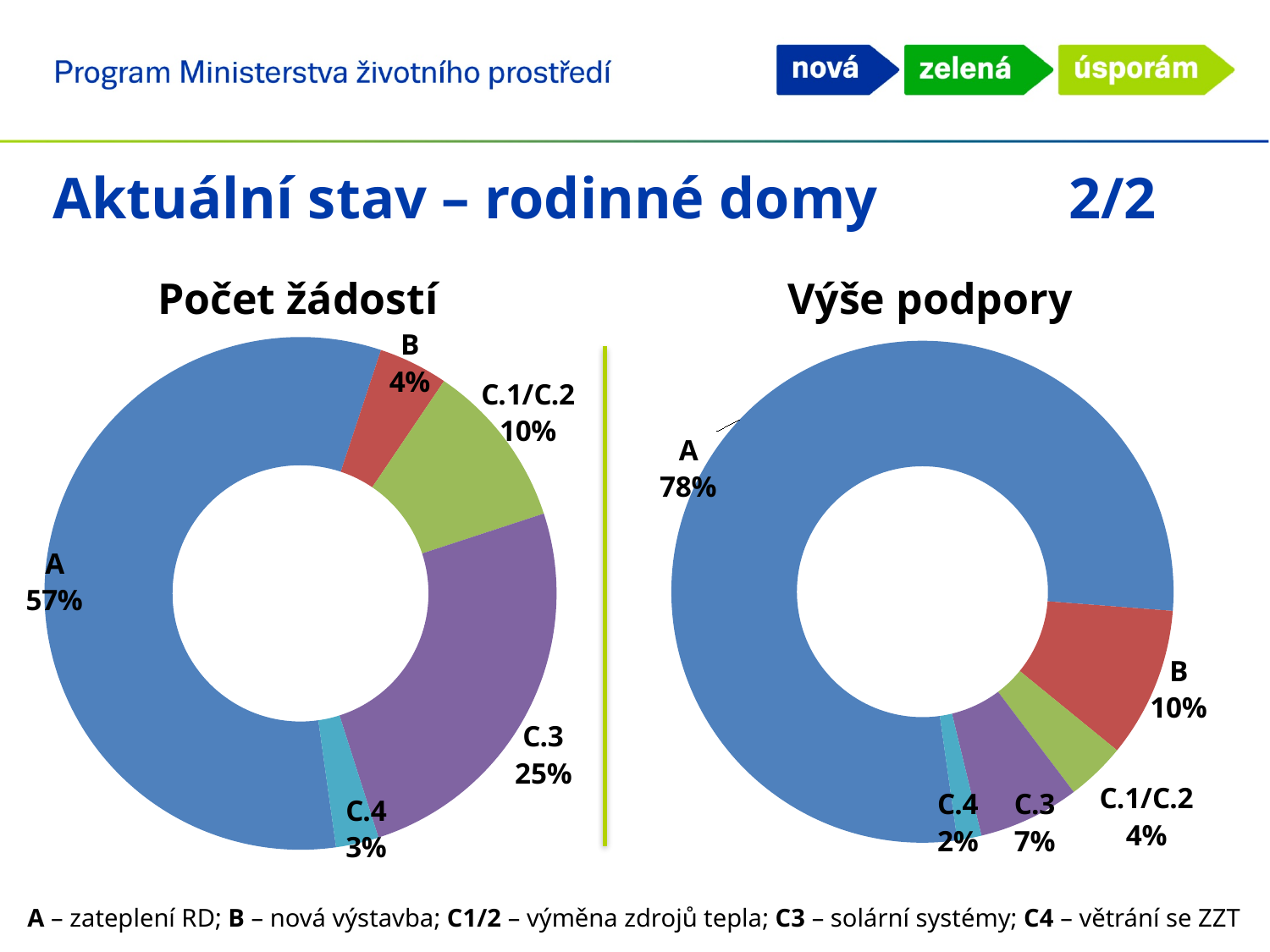
In the 'Počet žádostí' chart, what share does category A have? 57% In the 'Počet žádostí' chart, which category has the smallest share? C.4 What is the title of the chart on the left side of the slide? Počet žádostí In the 'Výše podpory' chart, which is larger, the share of C.3 or the share of C.1/C.2? C.3 In the 'Výše podpory' chart, what share does category B have? 10% In the 'Výše podpory' chart, which category has the largest share? A What kind of chart is the 'Výše podpory' chart? Doughnut chart In the 'Počet žádostí' chart, what is the difference between the shares of A and C.3? 32% In the 'Výše podpory' chart, what share does category A have? 78% In the 'Výše podpory' chart, what share does category C.4 have? 2% How many categories are shown in the 'Počet žádostí' chart? 5 In the 'Počet žádostí' chart, what share does category C.3 have? 25%